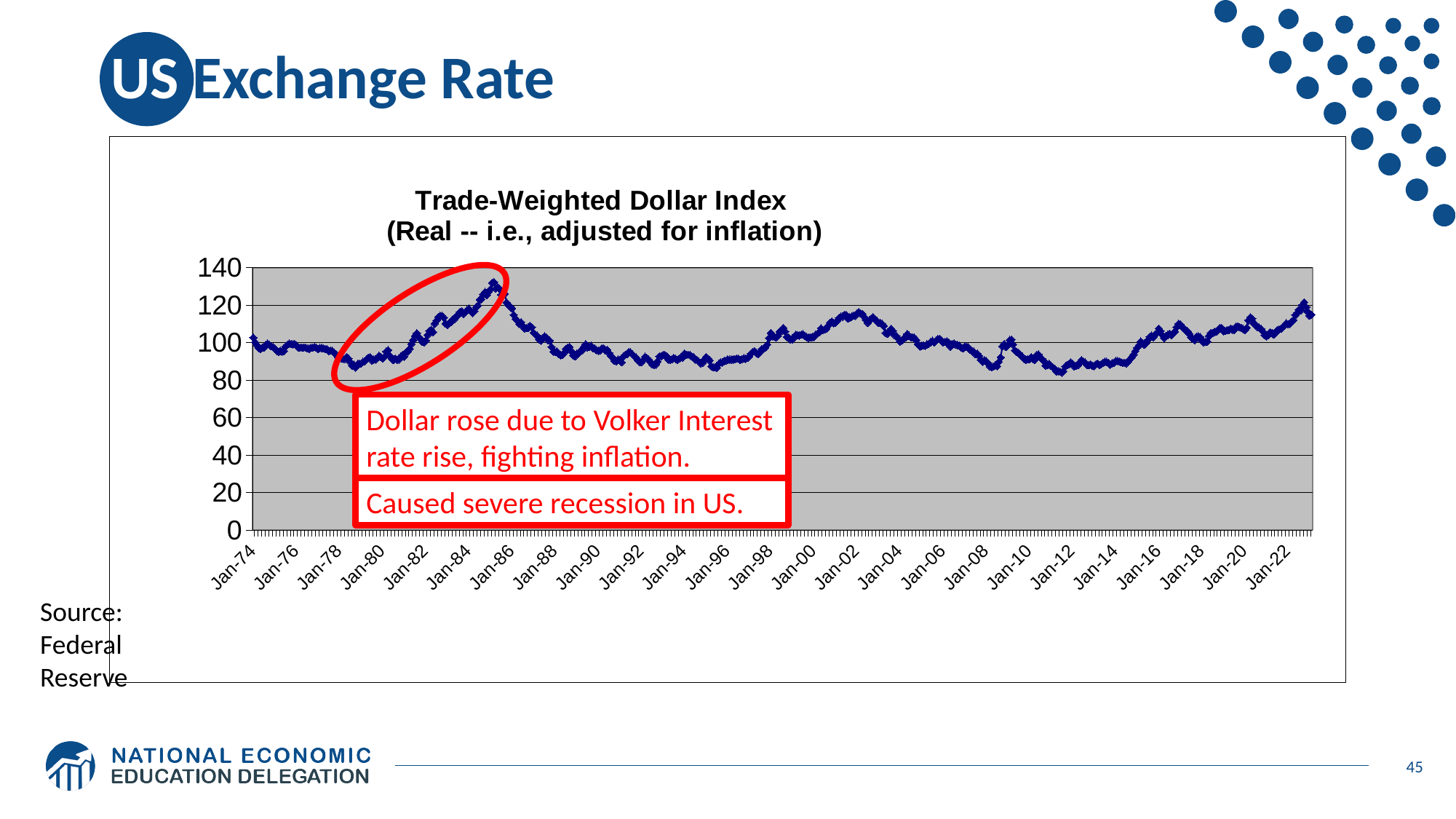
What kind of chart is shown on the slide? line chart Around which x-axis label does the Trade-Weighted Dollar Index reach its highest value? Jan-86 How many labels are shown on the x axis? 25 Is the value of the index around Jan-12 greater or less than 100? less What is the highest value shown on the y axis? 140 Is the peak value of the index around Jan-86 greater or less than 120? greater What is the title of the chart? Trade-Weighted Dollar Index (Real -- i.e., adjusted for inflation) Does the index rise or fall between Jan-02 and Jan-08? fall Is the value of the index around Jan-02 greater or less than 100? greater Does the index rise or fall between Jan-86 and Jan-88? fall Does the index rise or fall between Jan-80 and Jan-86? rise